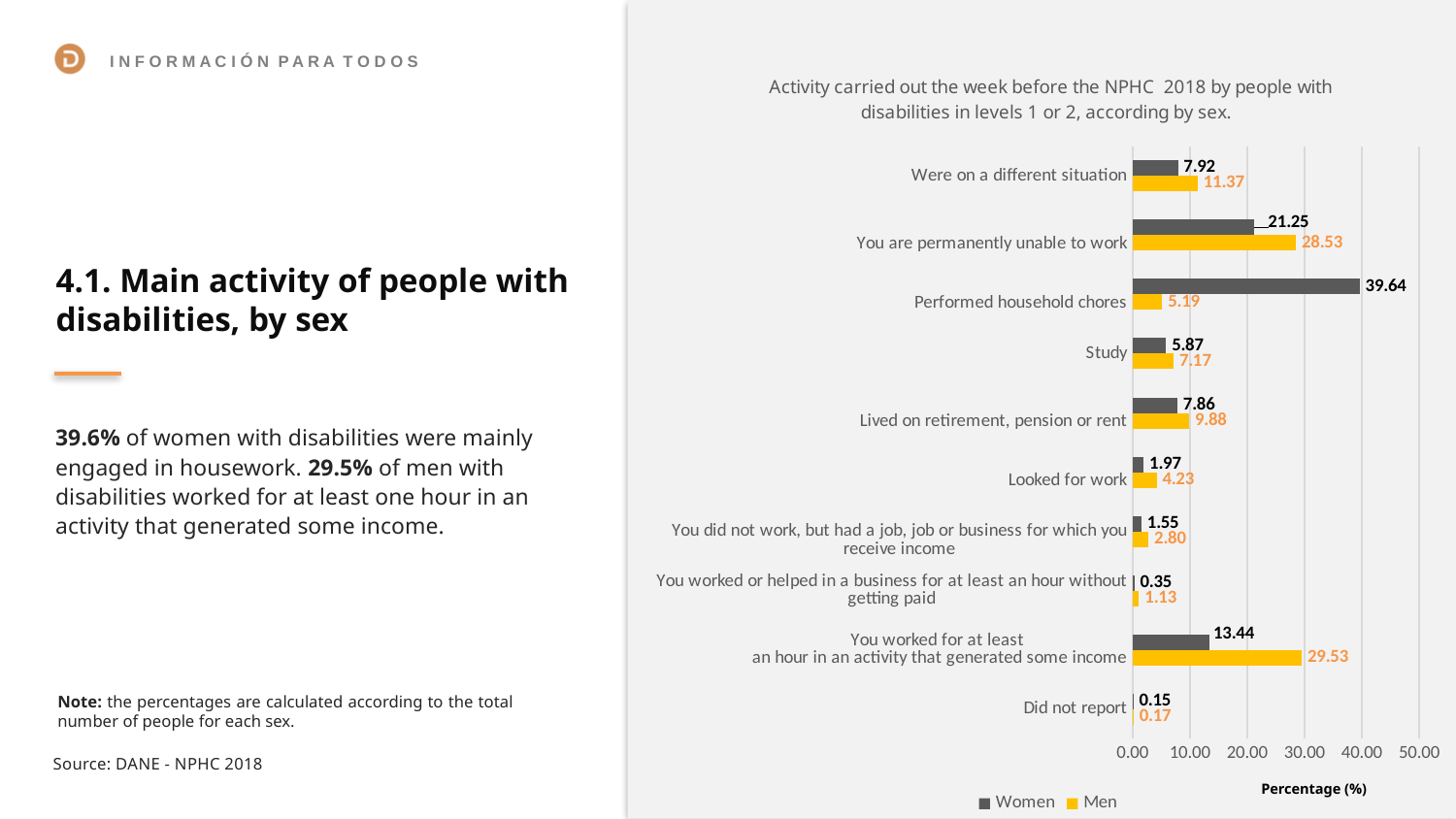
Is the value for Women for 'You are permanently unable to work' greater or less than 20.00? greater What kind of chart is shown on the slide? Bar chart What is the value for Women for 'Performed household chores'? 39.64 Which category has the highest value for Women? Performed household chores How many categories are shown on the chart? 10 How many series does the legend list? 2 Which is larger for 'Study': the value for Women or the value for Men? Men What is the difference between the Men and Women values for 'Looked for work'? 2.26 What is the value for Men for 'You worked for at least an hour in an activity that generated some income'? 29.53 What is the label of the horizontal axis? Percentage (%) Which category has the lowest value for Men? Did not report What is the value for Men for 'You are permanently unable to work'? 28.53